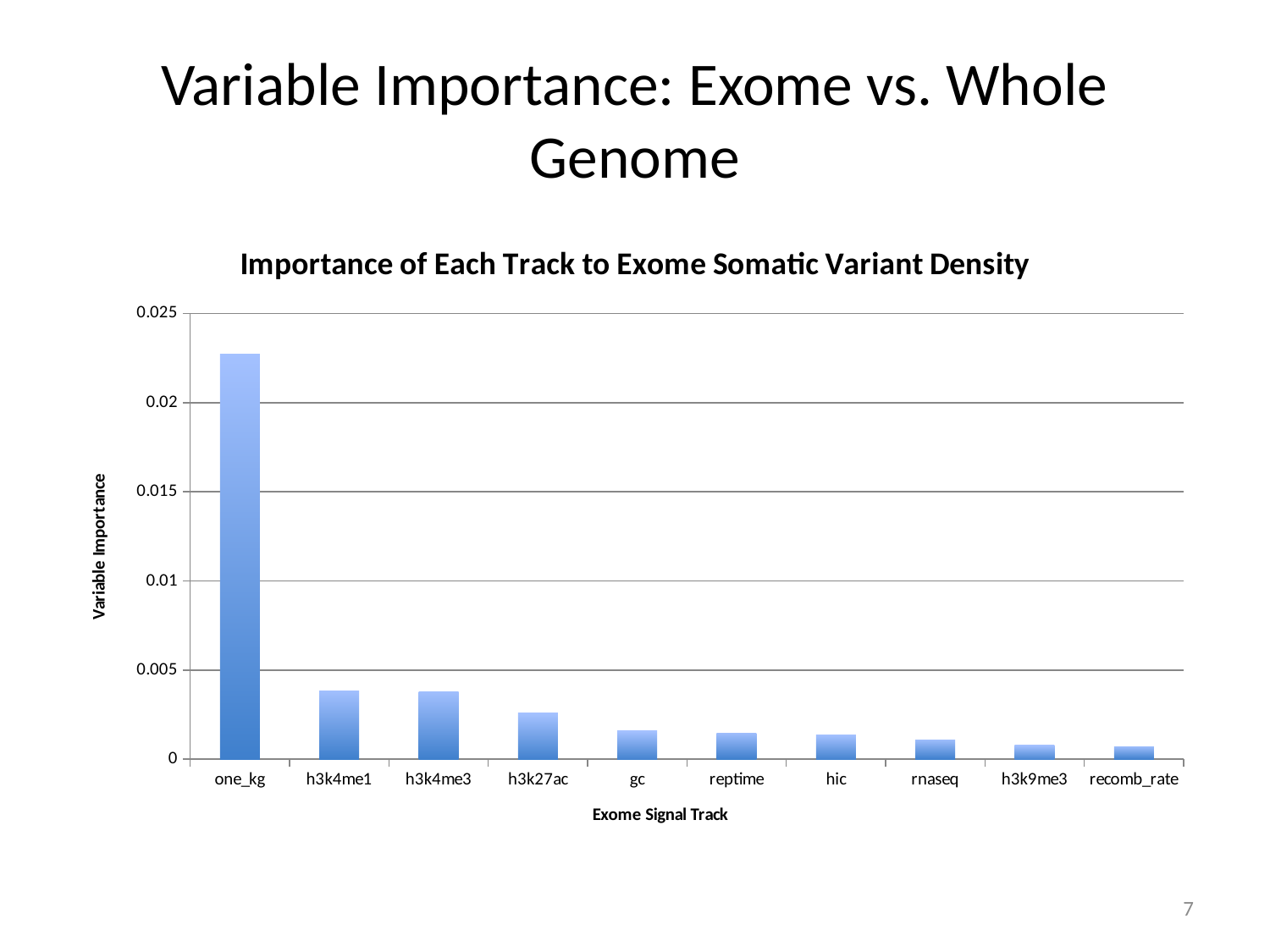
How many exome signal tracks are plotted on the x axis? 10 Which has a larger variable importance, h3k27ac or rnaseq? h3k27ac What is the title of the chart? Importance of Each Track to Exome Somatic Variant Density Which has a larger variable importance, h3k4me1 or h3k27ac? h3k4me1 Is the value for h3k27ac greater or less than 0.005? less Which has a larger variable importance, one_kg or h3k4me1? one_kg Is the value for h3k4me1 greater or less than 0.005? less Do the variable importance values generally rise or fall moving from left to right along the x axis? fall Which exome signal track has the highest variable importance? one_kg What kind of chart is shown on the slide? bar chart Is the value for one_kg greater or less than 0.02? greater